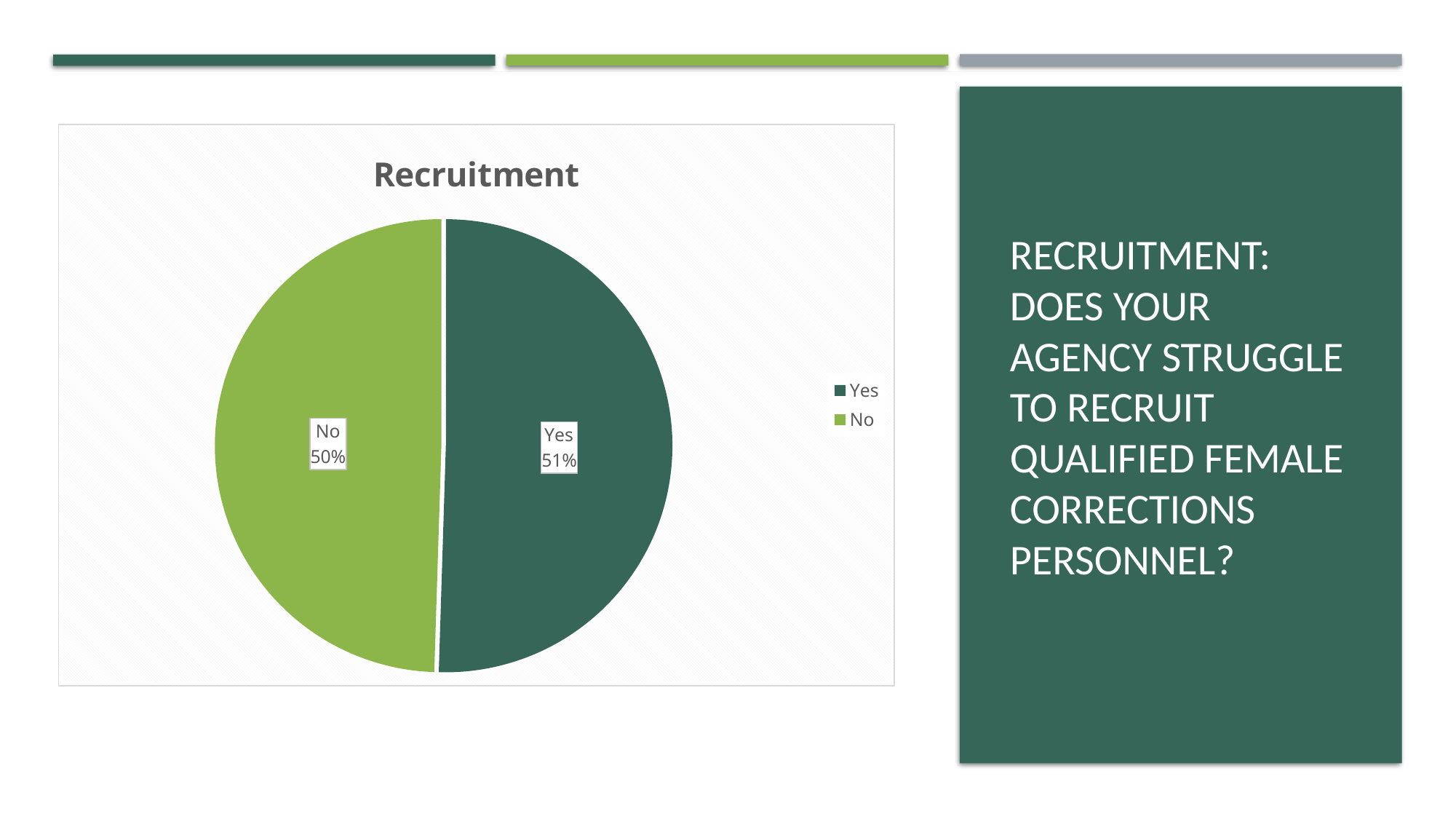
What percentage of the pie is labelled Yes? 51% What percentage of the pie is labelled No? 50% Which slice has the larger printed percentage, Yes or No? Yes What type of chart is shown on the slide? pie chart How many entries does the legend list? 2 Which slice has the largest printed percentage? Yes What is the title of the chart? Recruitment Which slice has the smallest printed percentage? No What is the difference between the Yes and No percentages? 1% Which legend entry is shown in dark green? Yes How many slices does the pie chart have? 2